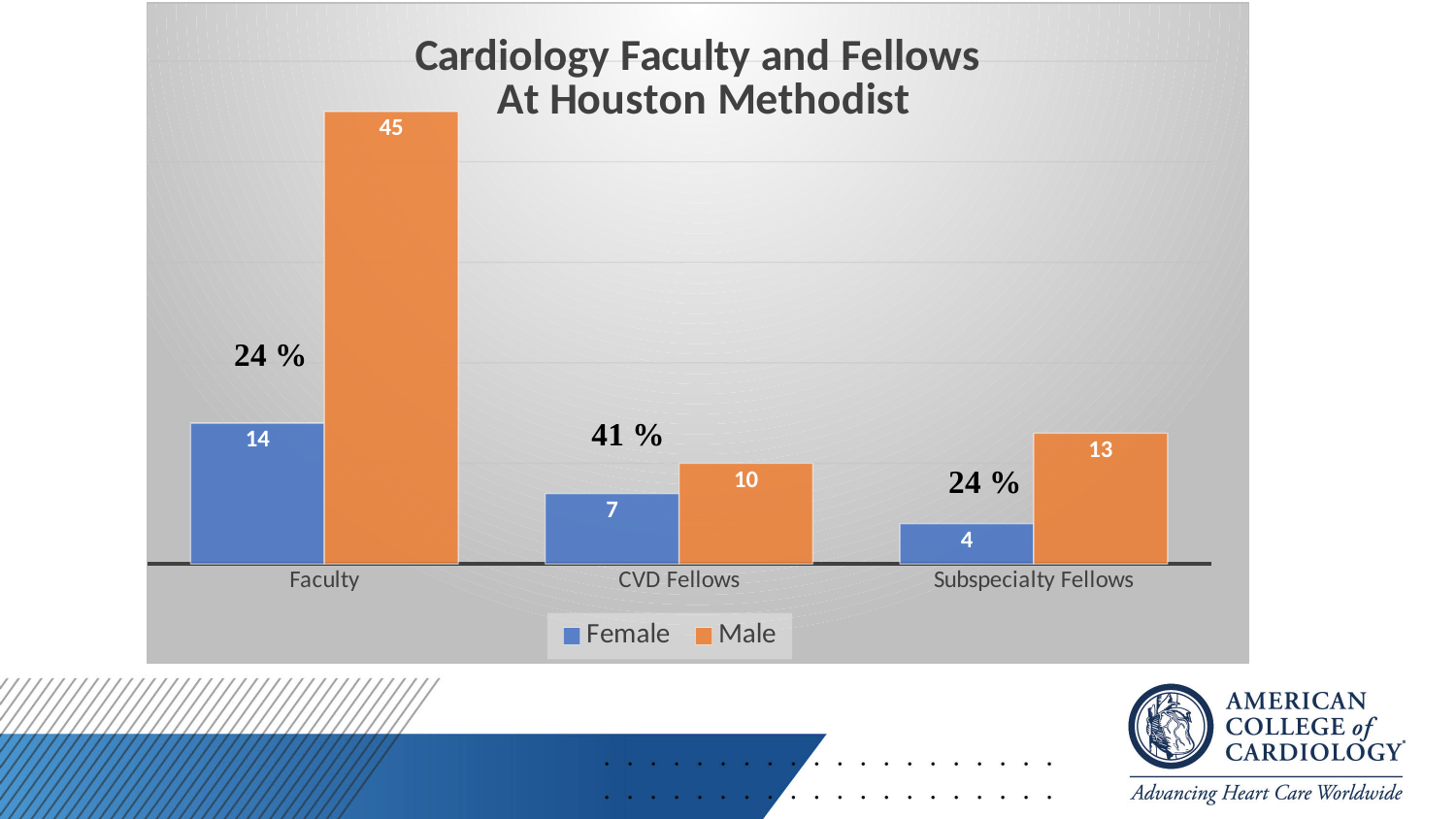
How many series does the legend list? 2 What is the value for Male in the Subspecialty Fellows category? 13 Which category has the lowest Female value? Subspecialty Fellows What kind of chart is shown? Bar chart Which category has the highest Male value? Faculty What is the difference between the Male and Female values for Faculty? 31 What is the value for Male in the Faculty category? 45 What percentage is annotated above the CVD Fellows category? 41 % What is the value for Female in the CVD Fellows category? 7 What is the title of the chart? Cardiology Faculty and Fellows At Houston Methodist How many categories are shown on the x axis? 3 Which is larger in the CVD Fellows category, Female or Male? Male